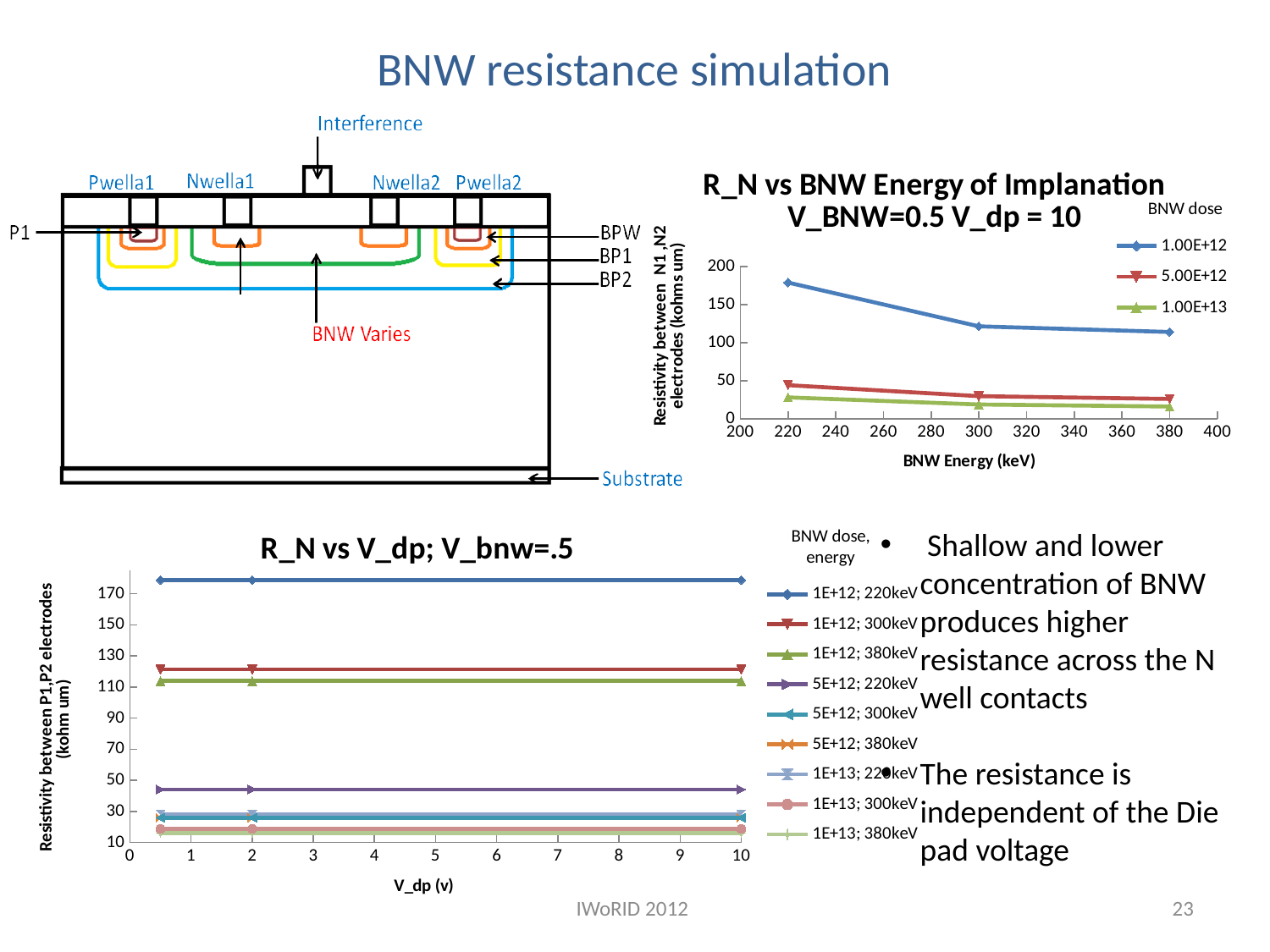
In the chart titled 'R_N vs V_dp; V_bnw=.5', do the values for the 1E+12; 220keV series rise, fall, or stay flat as V_dp increases? stay flat In the chart titled 'R_N vs BNW Energy of Implanation', how many series does the legend list? 3 In the chart titled 'R_N vs BNW Energy of Implanation', which series has the lowest resistivity values? 1.00E+13 In the chart titled 'R_N vs BNW Energy of Implanation', what is the x-axis label? BNW Energy (keV) In the chart titled 'R_N vs BNW Energy of Implanation', is the value for the 1.00E+12 series at 220 keV greater or less than 150? greater In the chart titled 'R_N vs BNW Energy of Implanation', which series has the highest resistivity values? 1.00E+12 In the chart titled 'R_N vs BNW Energy of Implanation', what kind of chart is it? line chart In the chart titled 'R_N vs V_dp; V_bnw=.5', how many series does the legend list? 9 In the chart titled 'R_N vs V_dp; V_bnw=.5', is the value for the 5E+12; 220keV series greater or less than 50? less In the chart titled 'R_N vs BNW Energy of Implanation', is the value for the 5.00E+12 series at 380 keV greater or less than 50? less In the chart titled 'R_N vs BNW Energy of Implanation', do the values for the 1.00E+12 series rise or fall as BNW Energy increases? fall In the chart titled 'R_N vs V_dp; V_bnw=.5', which is larger, the value for 1E+12; 300keV or the value for 5E+12; 220keV? 1E+12; 300keV